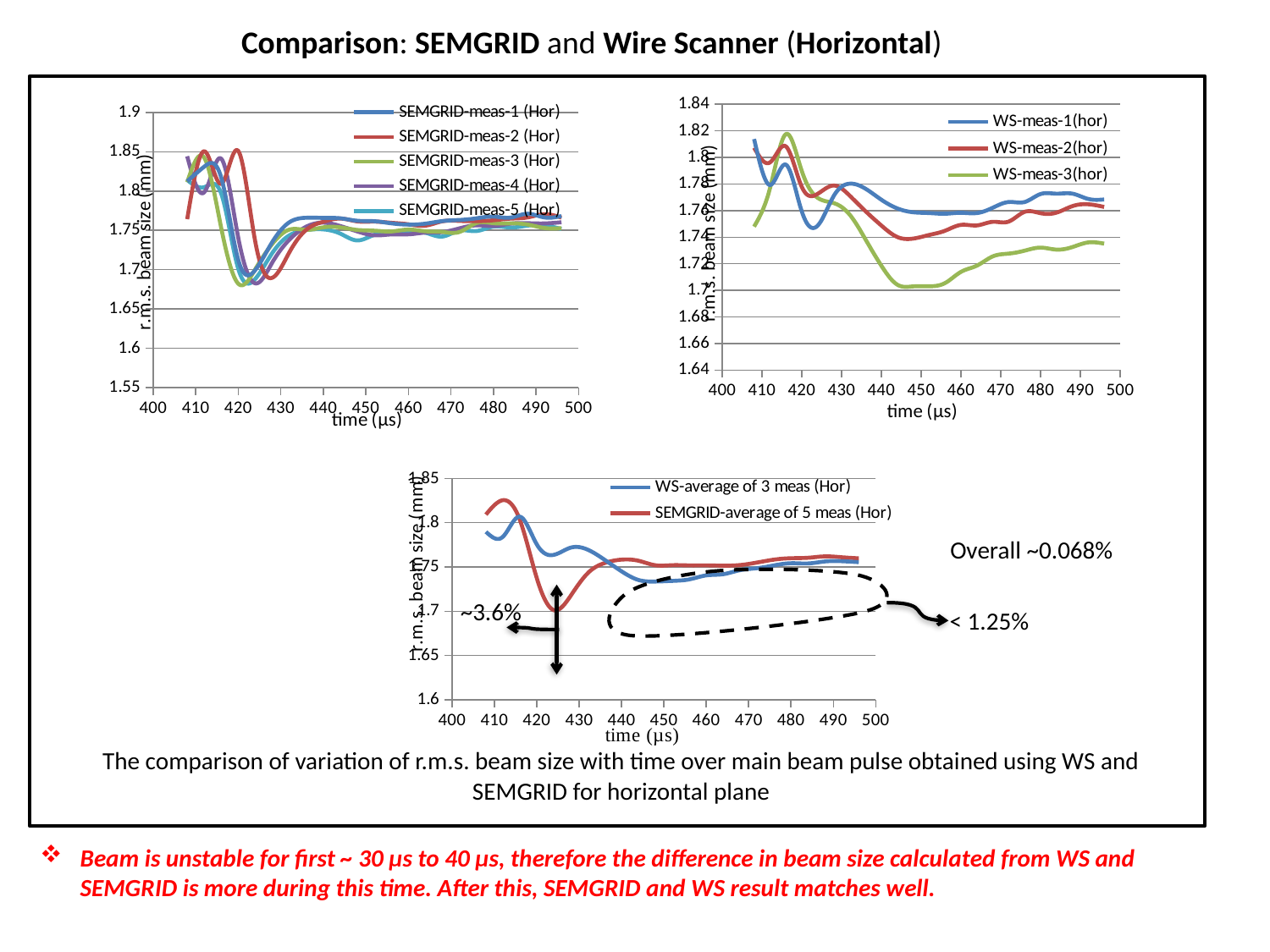
How many series does the legend of the top-right chart (WS measurements) list? 3 What overall percentage difference is annotated on the bottom chart (averages)? ~0.068% In the top-right chart, at 450 µs, which series has the larger value: WS-meas-1(hor) or WS-meas-3(hor)? WS-meas-1(hor) In the top-right chart, is the value of WS-meas-3(hor) at 450 µs greater or less than 1.74? less In the bottom chart, is the value of WS-average of 3 meas (Hor) at 415 µs greater or less than 1.75? greater In the bottom chart, is the value of SEMGRID-average of 5 meas (Hor) at 425 µs greater or less than 1.75? less In the bottom chart, at 425 µs, which series has the larger value: WS-average of 3 meas (Hor) or SEMGRID-average of 5 meas (Hor)? WS-average of 3 meas (Hor) How many series does the legend of the bottom chart (averages) list? 2 How many series does the legend of the top-left chart (SEMGRID measurements) list? 5 What is the y-axis label of the top-left chart (SEMGRID measurements)? r.m.s. beam size (mm) What kind of chart is the top-left chart (SEMGRID measurements)? line chart